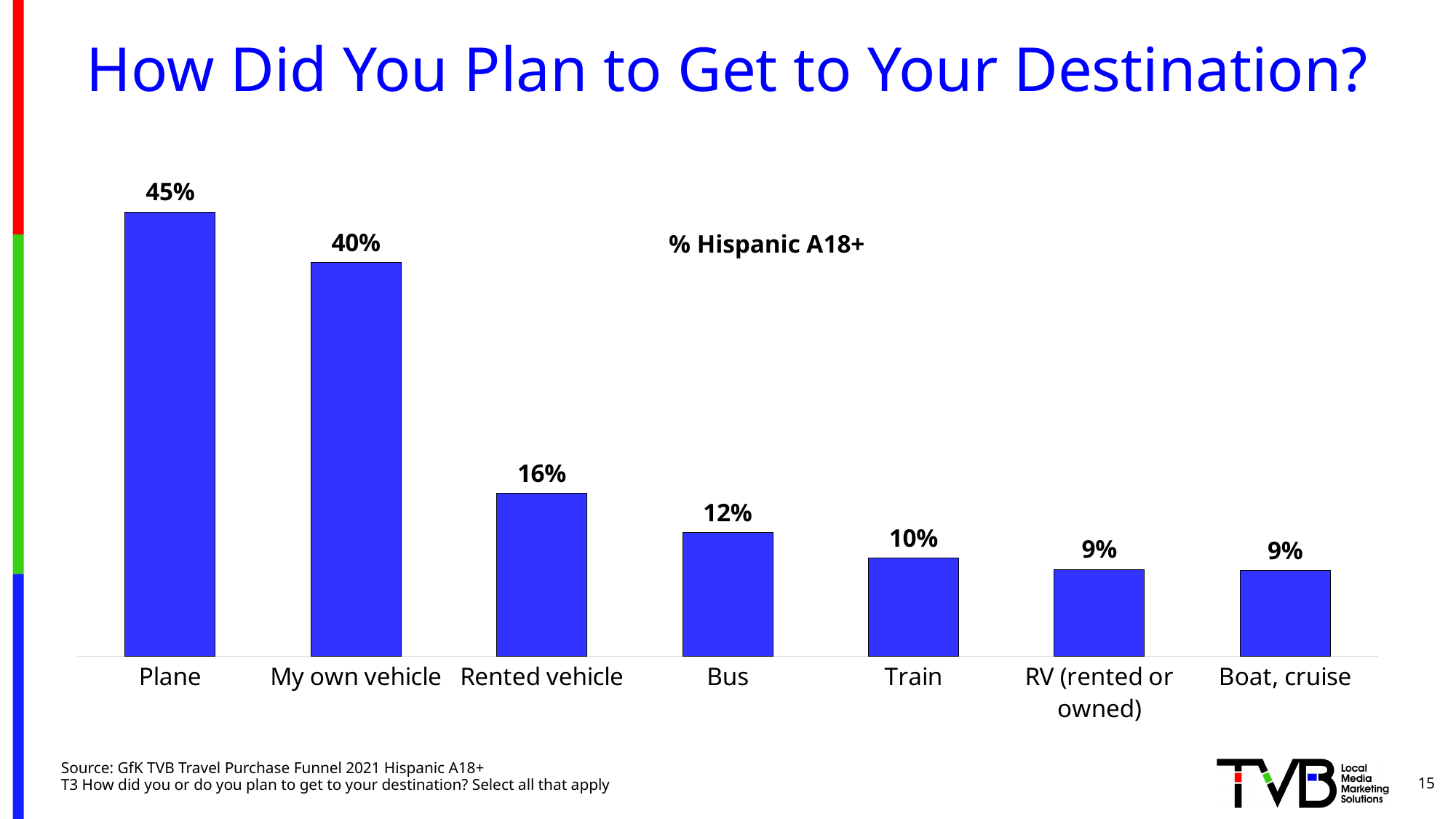
Which mode of transportation has the highest percentage? Plane What is the value for 'Train'? 10% What type of chart is shown on the slide? Bar chart What percentage is shown for 'Rented vehicle'? 16% What label is shown above the chart describing the population measured? % Hispanic A18+ What is the difference between the values for 'Rented vehicle' and 'Bus'? 4% Do the values rise or fall moving from left to right across the categories? Fall What is the difference between the percentages for 'Plane' and 'My own vehicle'? 5% Which is larger, the value for 'Bus' or the value for 'Train'? Bus How many transportation categories are shown in the chart? 7 What percentage of Hispanic adults 18+ planned to get to their destination by plane? 45% What is the value shown for 'My own vehicle'? 40%